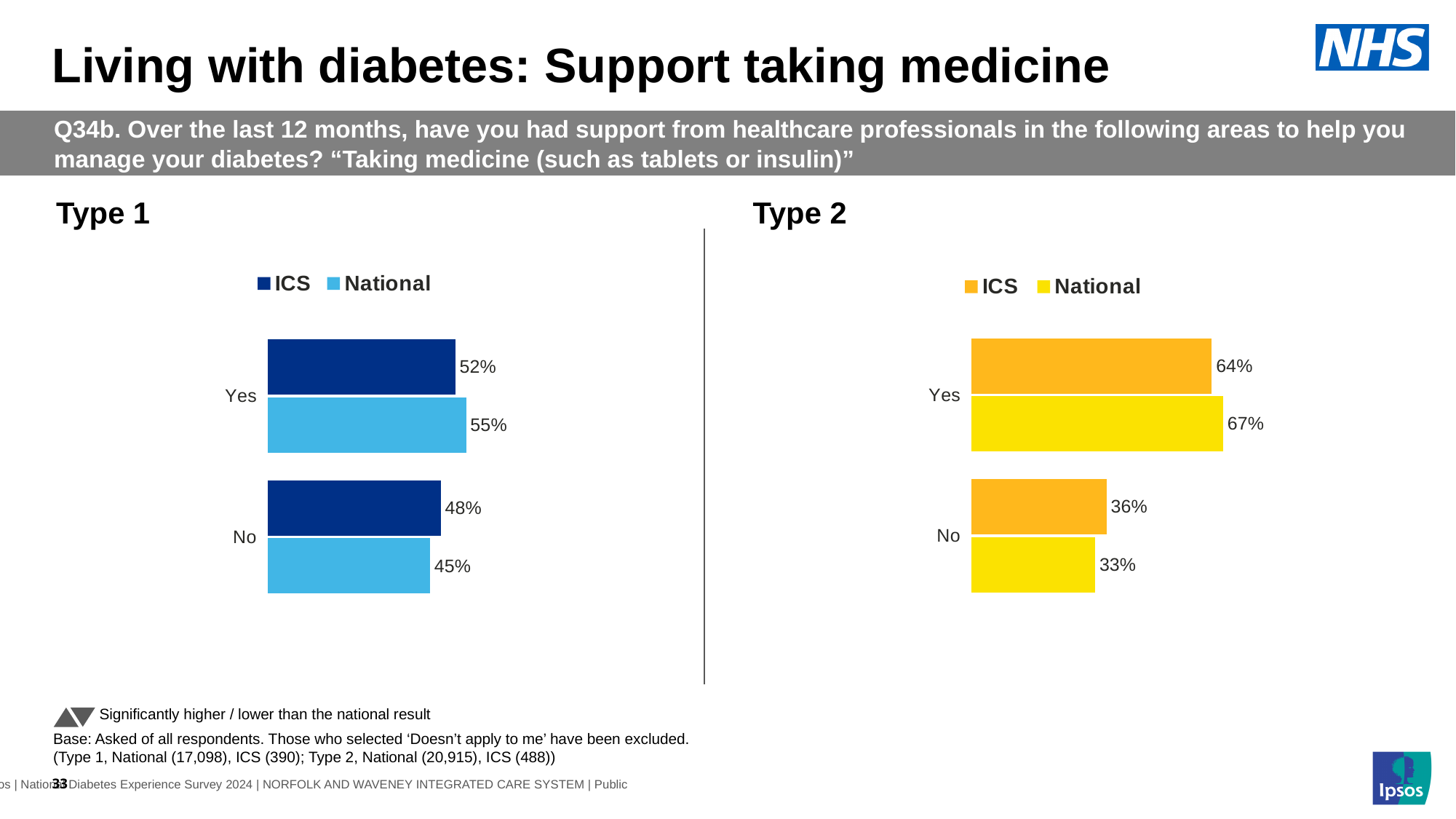
In the Type 2 chart, what is the difference between the National and ICS values for Yes? 3% How many categories are shown in the Type 2 chart? 2 In the Type 1 chart, what is the ICS value for Yes? 52% In the Type 1 chart, which is larger for No: ICS or National? ICS In the Type 1 chart, which category has the lowest National value? No In the Type 1 chart, what is the National value for No? 45% In the Type 2 chart, which is larger for Yes: ICS or National? National What kind of chart is the Type 1 chart? Bar chart In the Type 2 chart, what is the National value for Yes? 67% In the Type 2 chart, what is the ICS value for No? 36% How many series does the legend of the Type 1 chart list? 2 In the Type 2 chart, which category has the highest National value? Yes